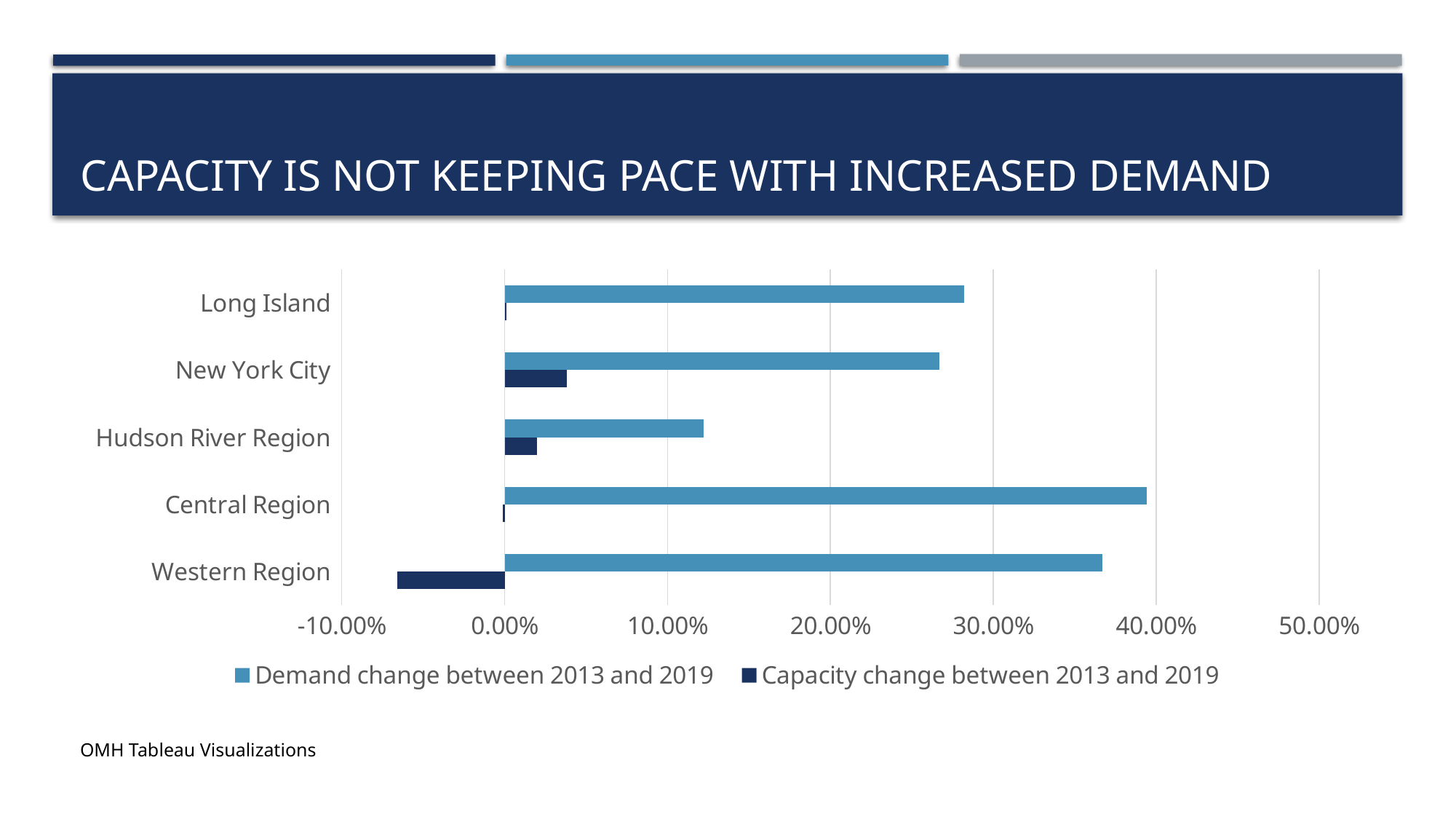
Which region has the lowest capacity change between 2013 and 2019? Western Region Which region has the lowest demand change between 2013 and 2019? Hudson River Region How many series does the legend list? 2 Which region has the highest demand change between 2013 and 2019? Central Region Is the demand change for Long Island greater or less than 20.00%? greater Which region has the highest capacity change between 2013 and 2019? New York City Is the demand change for Central Region greater or less than 30.00%? greater Which is larger, the demand change for Western Region or for Hudson River Region? Western Region Is the capacity change for Western Region greater or less than 0.00%? less What kind of chart is shown on the slide? bar chart How many regions are shown on the chart? 5 What is the title of the slide? CAPACITY IS NOT KEEPING PACE WITH INCREASED DEMAND